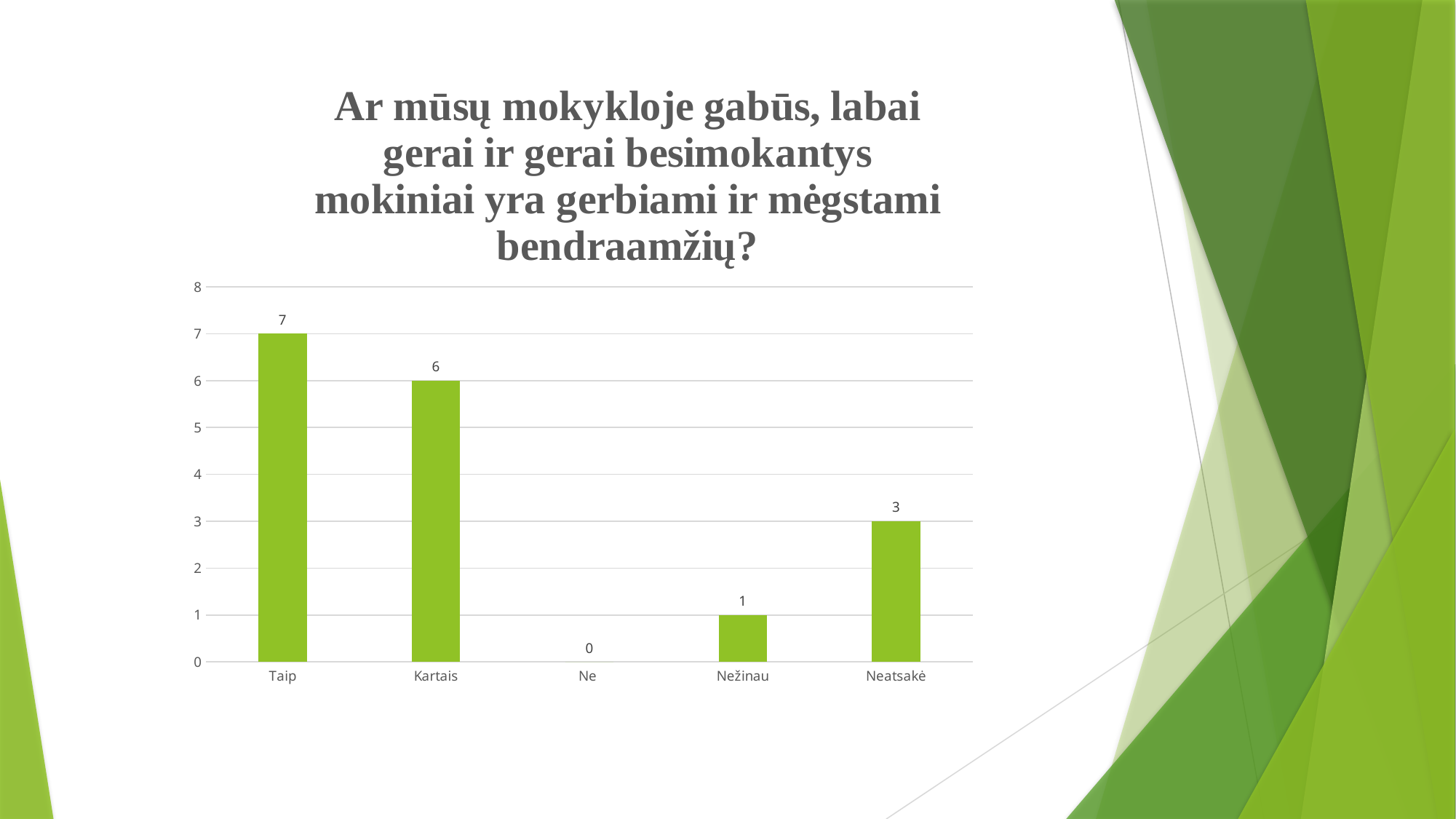
What is the total of all the values shown in the chart? 17 Which category has the highest value? Taip How many categories are shown on the x axis? 5 What is the value for Nežinau? 1 What is the value for Ne? 0 What is the value for Taip? 7 Which is larger, the value for Kartais or the value for Neatsakė? Kartais What is the difference between the values for Taip and Neatsakė? 4 What kind of chart is shown on the slide? Bar chart What is the value for Kartais? 6 What is the value for Neatsakė? 3 Which category has the lowest value? Ne